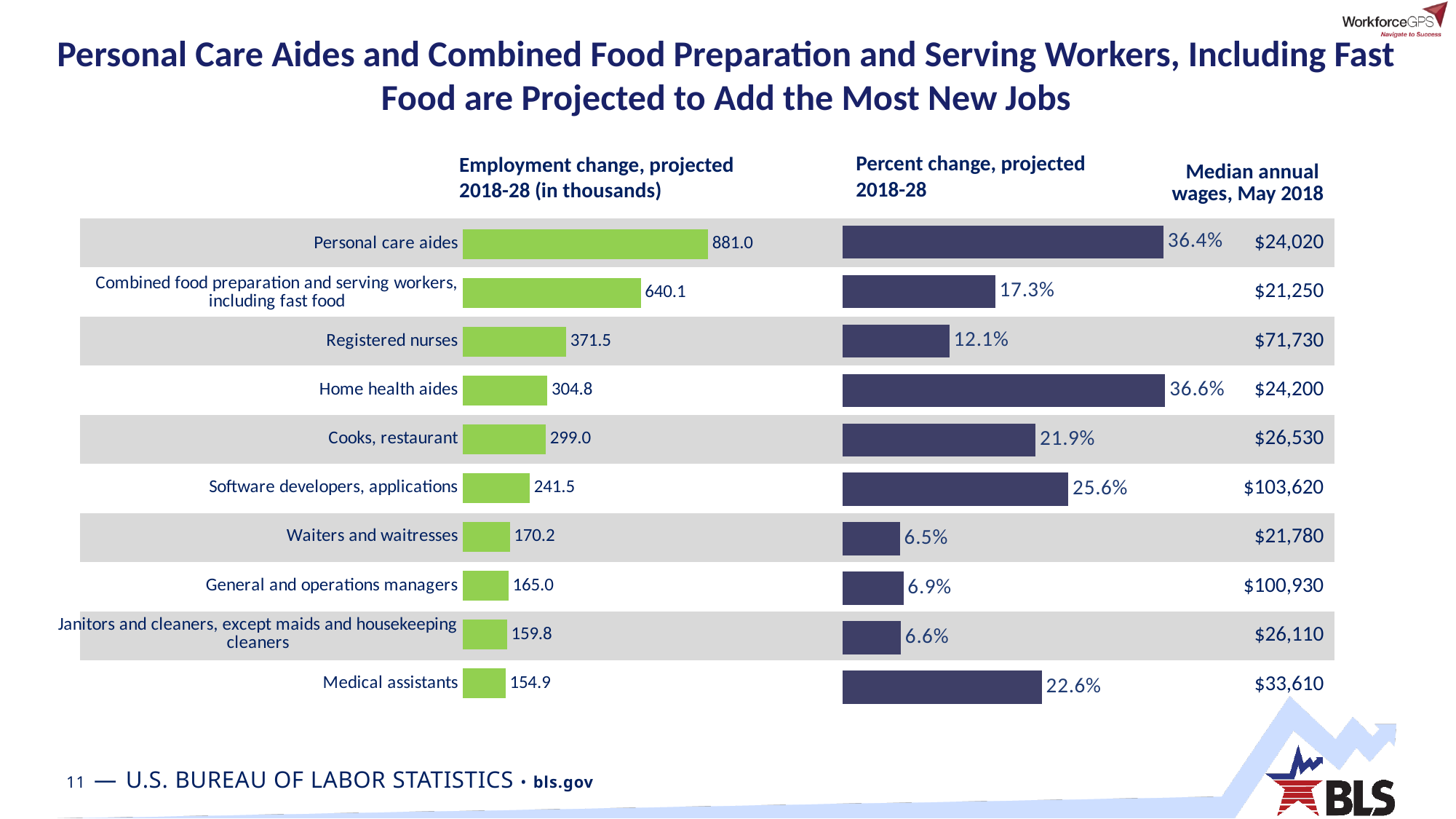
In the 'Employment change, projected 2018-28 (in thousands)' chart, what is the value for Registered nurses? 371.5 In the 'Employment change, projected 2018-28 (in thousands)' chart, which is larger: Software developers, applications or Home health aides? Home health aides In the 'Employment change, projected 2018-28 (in thousands)' chart, which occupation has the lowest value? Medical assistants In the 'Percent change, projected 2018-28' chart, which is larger: Software developers, applications or Cooks, restaurant? Software developers, applications In the 'Percent change, projected 2018-28' chart, what is the difference between Software developers, applications and Registered nurses? 13.5% In the 'Employment change, projected 2018-28 (in thousands)' chart, which occupation has the highest value? Personal care aides In the 'Percent change, projected 2018-28' chart, what is the value for Cooks, restaurant? 21.9% How many occupations are shown in the 'Employment change, projected 2018-28 (in thousands)' chart? 10 What colour are the bars in the 'Employment change, projected 2018-28 (in thousands)' chart? Green In the 'Employment change, projected 2018-28 (in thousands)' chart, what is the difference between Personal care aides and Combined food preparation and serving workers, including fast food? 240.9 In the 'Percent change, projected 2018-28' chart, what is the value for Medical assistants? 22.6% What kind of chart is the 'Percent change, projected 2018-28' chart? Bar chart